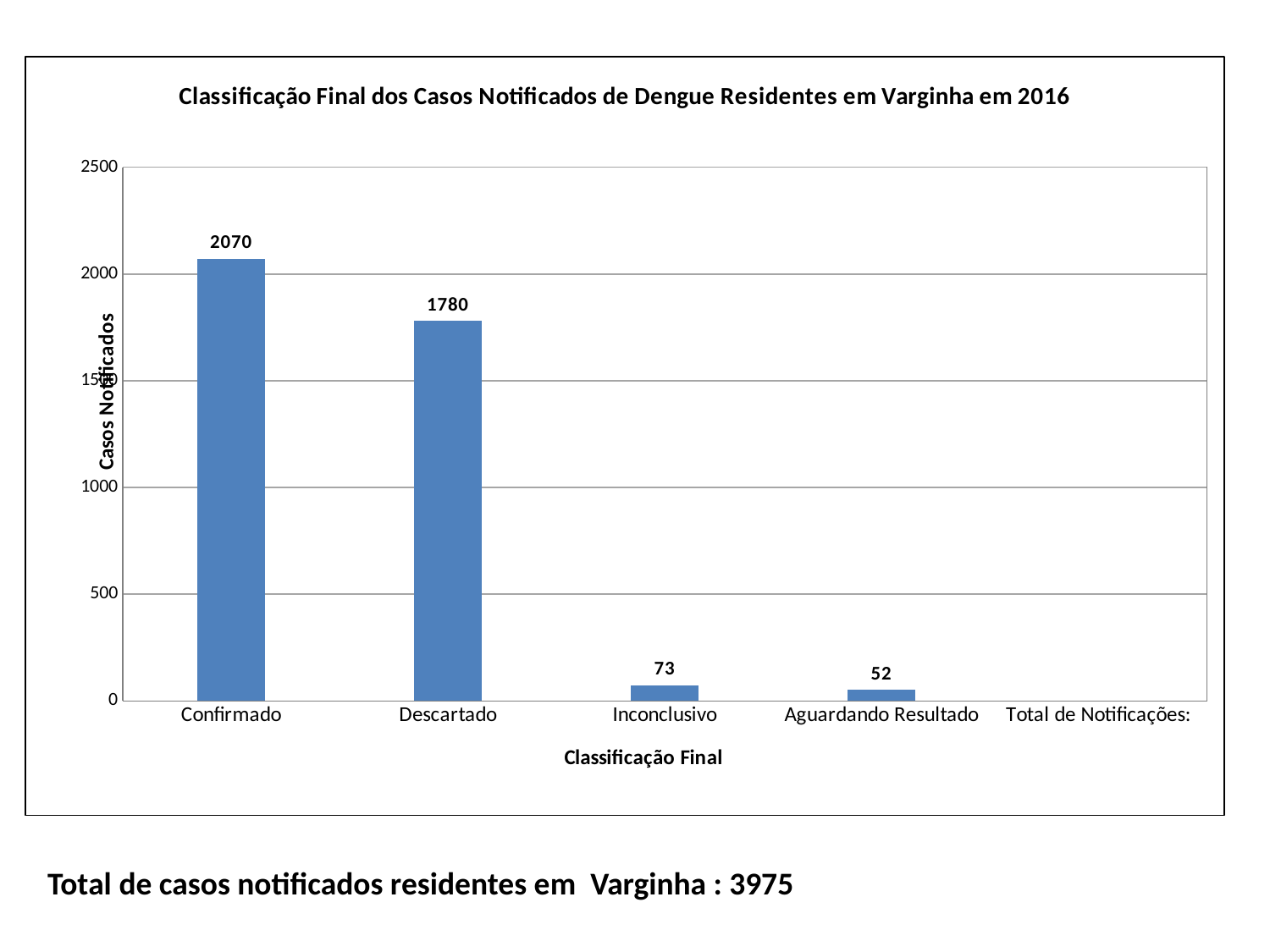
Which is larger, the value for Descartado or the value for Inconclusivo? Descartado What is the title of the chart? Classificação Final dos Casos Notificados de Dengue Residentes em Varginha em 2016 Which category has the lowest plotted value? Aguardando Resultado What is the difference between the values for Confirmado and Descartado? 290 How many bars are plotted in the chart? 4 What is the difference between the values for Inconclusivo and Aguardando Resultado? 21 What is the value for Confirmado? 2070 What is the value for Aguardando Resultado? 52 What is the value for Descartado? 1780 What is the value for Inconclusivo? 73 Which category has the highest value? Confirmado What kind of chart is shown? Bar chart